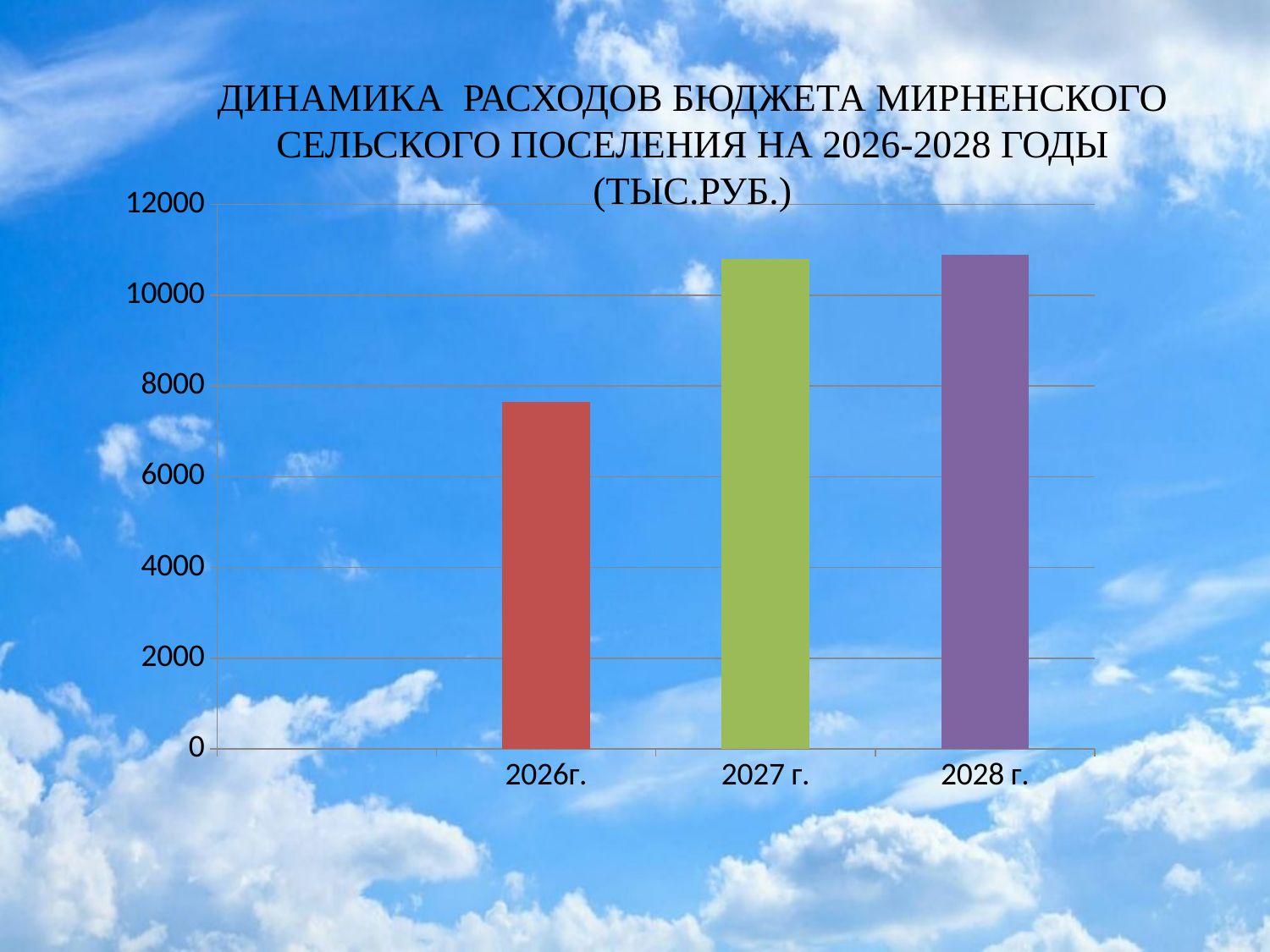
Which is larger, the value for 2026г. or the value for 2028 г.? 2028 г. Is the value for 2026г. greater or less than 6000? greater Do the values rise or fall from 2026г. to 2028 г.? rise Which is larger, the value for 2026г. or the value for 2027 г.? 2027 г. What kind of chart is shown on the slide? bar chart Is the value for 2027 г. greater or less than 10000? greater Is the value for 2026г. greater or less than 8000? less Which year has the lowest budget expenditure in the chart? 2026г. How many bars (years) are plotted in the chart? 3 In what units are the values in the chart expressed, according to the title? ТЫС.РУБ.